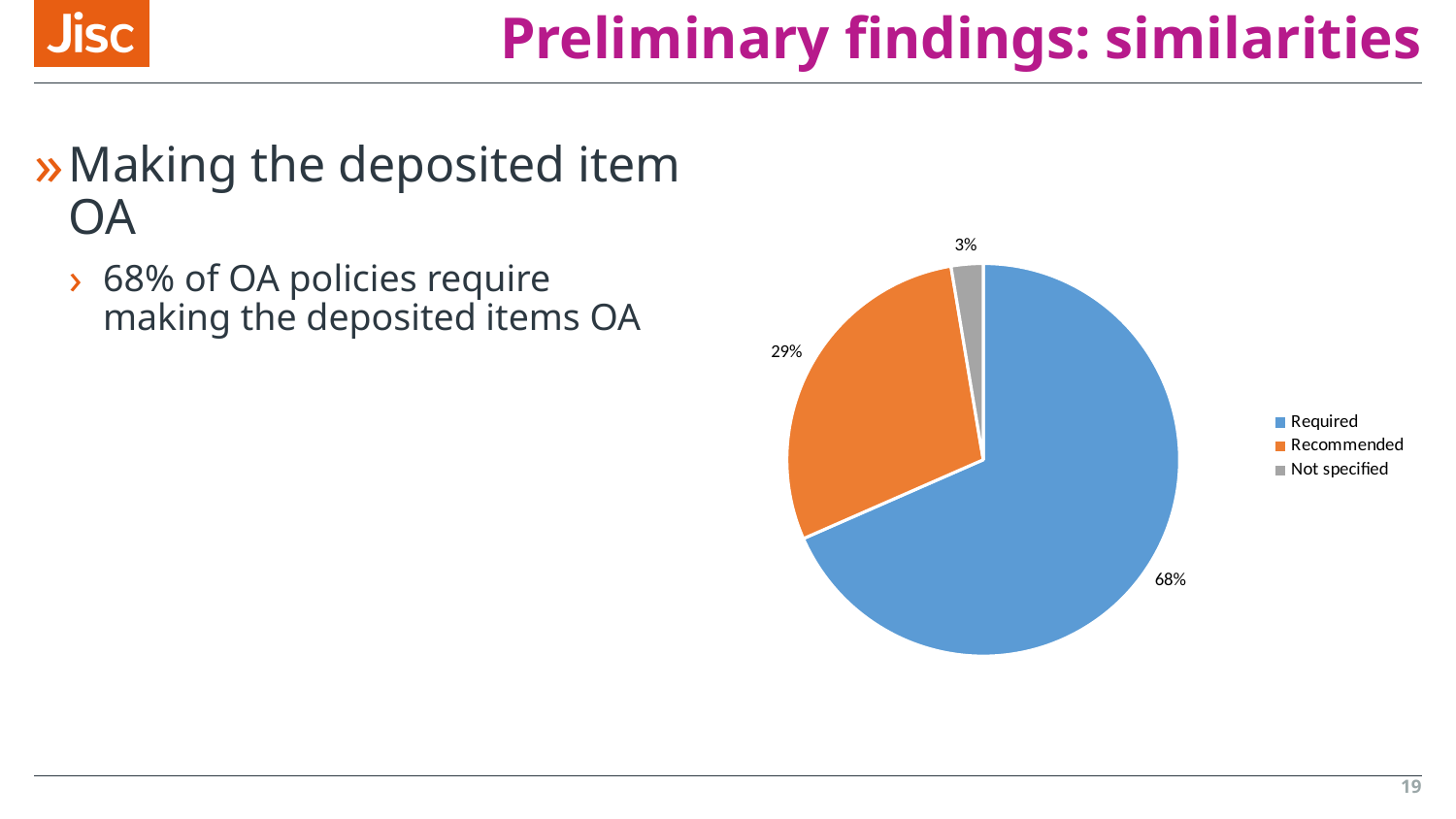
Which is larger, the Recommended slice or the Not specified slice? Recommended What share of the pie does the Required slice represent? 68% What share of the pie does the Not specified slice represent? 3% What colour is the Recommended slice in the pie chart? orange Which category has the smallest slice of the pie? Not specified What kind of chart is shown on the slide? pie chart What is the difference in percentage points between the Recommended and Not specified slices? 26 How many categories does the pie chart show? 3 Which category has the largest slice of the pie? Required What is the difference in percentage points between the Required and Recommended slices? 39 How many entries does the legend list? 3 What share of the pie does the Recommended slice represent? 29%